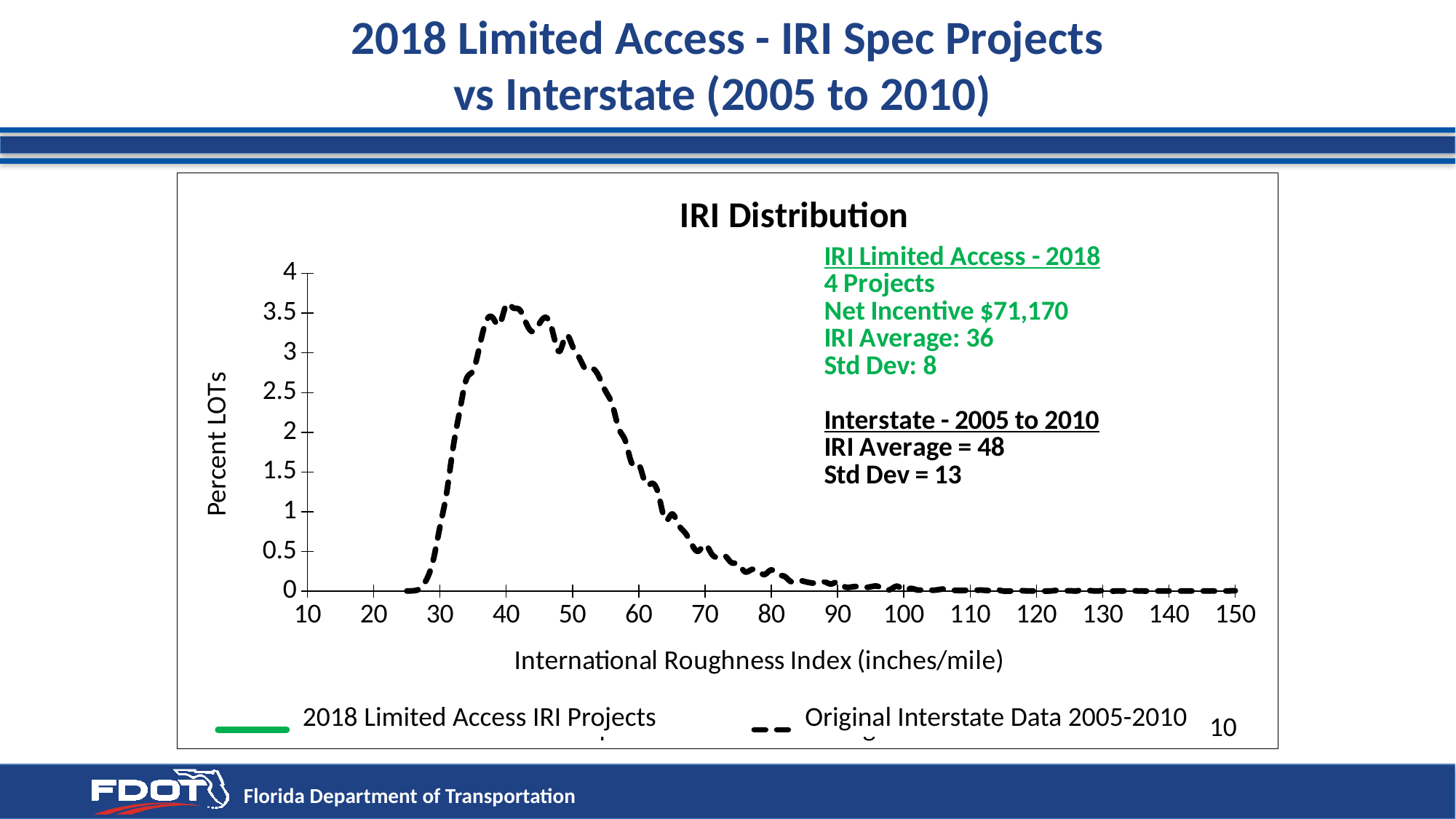
According to the annotation on the chart, what is the IRI Average for Limited Access 2018? 36 Is the value of the Original Interstate Data 2005-2010 line at an IRI of 50 greater or less than 2.5? greater Is the value of the Original Interstate Data 2005-2010 line at an IRI of 80 greater or less than 0.5? less What is the title of the chart? IRI Distribution Does the Original Interstate Data 2005-2010 line rise or fall as the IRI increases from 50 to 90? fall Is the value of the Original Interstate Data 2005-2010 line at an IRI of 100 greater or less than 0.5? less What kind of chart is shown on the slide? line chart Does the Original Interstate Data 2005-2010 line rise or fall as the IRI increases from 30 to 40? rise According to the annotation on the chart, what is the Std Dev for Interstate 2005 to 2010? 13 How many series does the legend of the IRI Distribution chart list? 2 What is the label of the y axis of the chart? Percent LOTs